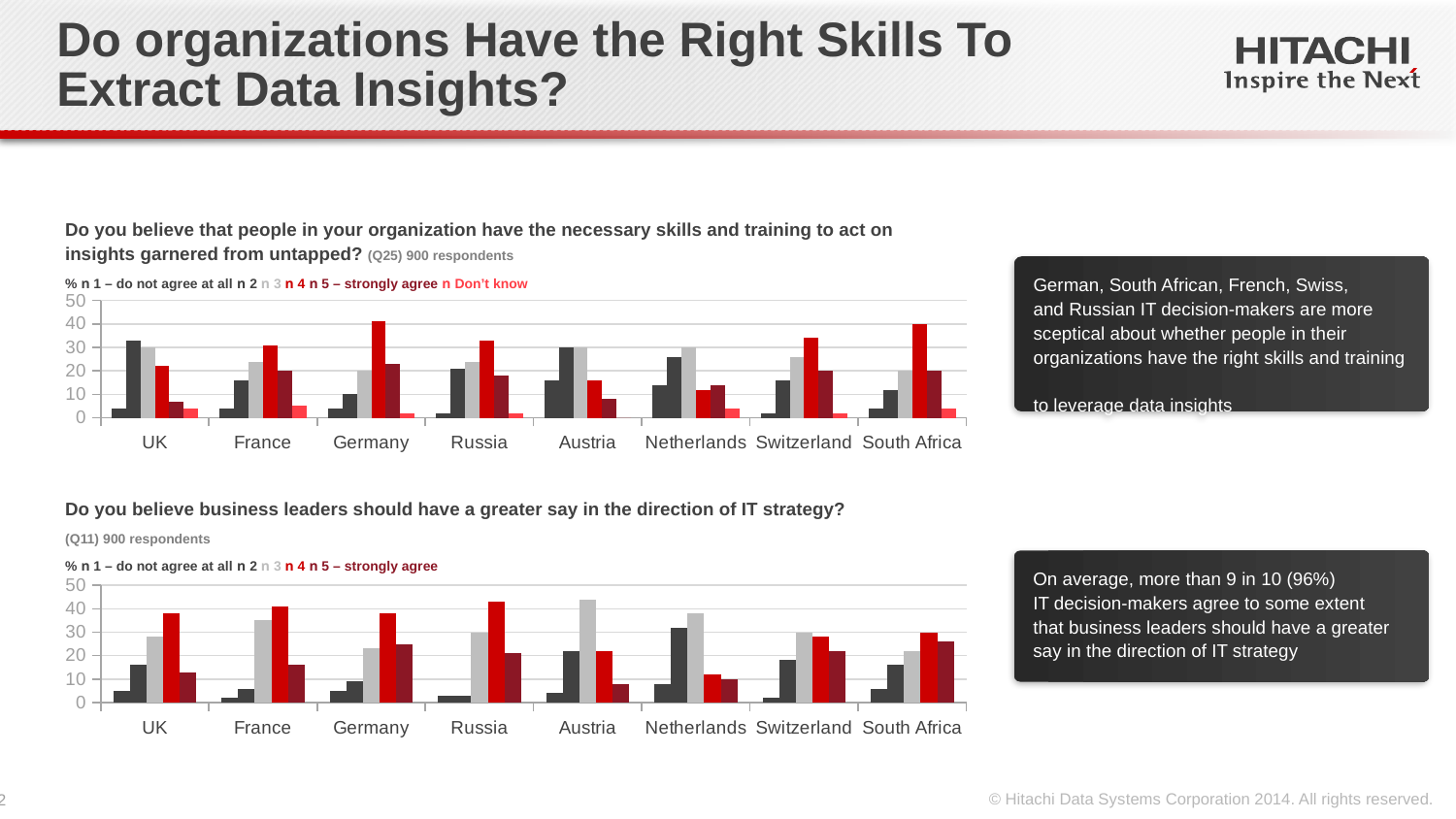
How many series does the legend of the bottom chart list? 5 In the top chart, is the value of the '1 – do not agree at all' series for Russia greater or less than 30? less In the bottom chart, is the value of the '3' series for Austria greater or less than 40? greater In the bottom chart, which country has the highest value for the '3' series? Austria How many countries are shown on the x axis of the bottom chart? 8 In the bottom chart, is the value of the '1 – do not agree at all' series for the UK greater or less than 10? less In the top chart, which country has the larger '4' bar: Germany or Austria? Germany In the top chart, for the UK, which is larger: the '1 – do not agree at all' bar or the '4' bar? 4 Which survey question number is the bottom chart based on? Q11 How many series does the legend of the top chart list? 6 What kind of chart is the top chart on the slide? bar chart